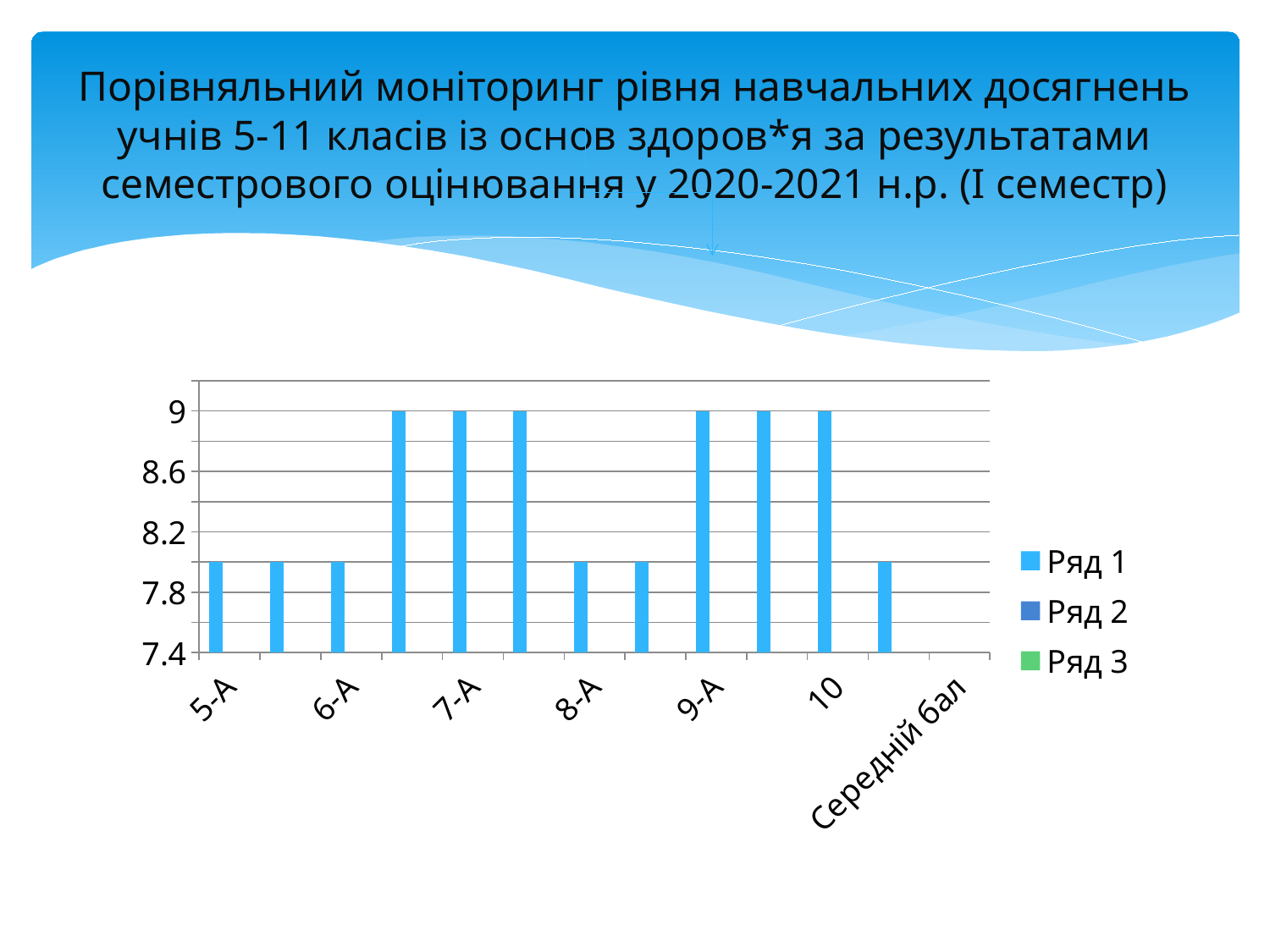
Is the value for 5-А greater or less than 8.2? less What is the value for 9-А? 9 Which is larger, the value for 7-А or the value for 5-А? 7-А What is the value for 10? 9 Which is larger, the value for 8-А or the value for 9-А? 9-А How many series does the legend list? 3 How many bars are plotted in the chart? 12 What kind of chart is shown on the slide? bar chart What is the value for 7-А? 9 What is the name of the first series in the legend? Ряд 1 Is the value for 6-А greater or less than 7.8? greater Is the value for 8-А greater or less than 8.6? less